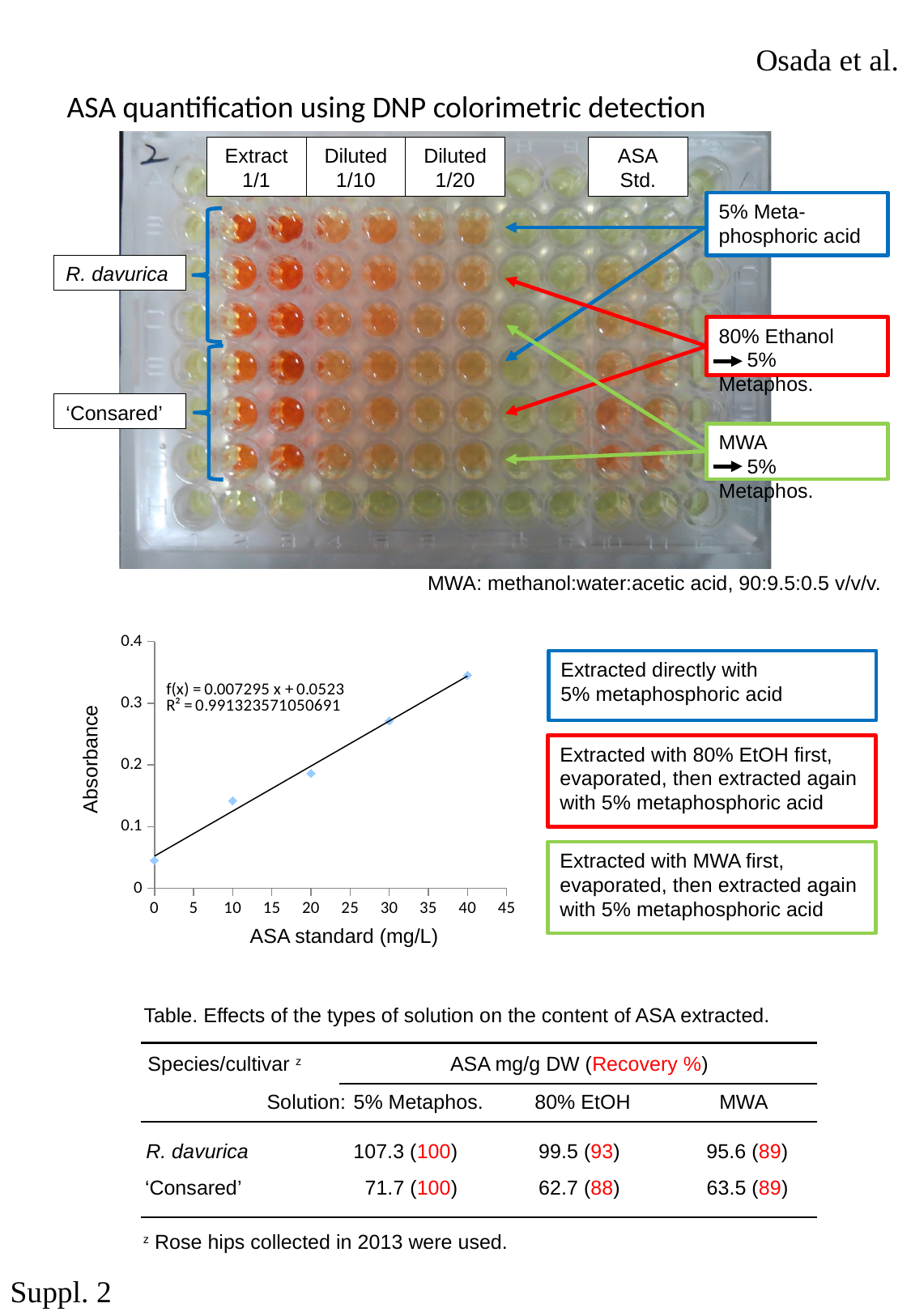
At which ASA standard concentration is the absorbance highest? 40 Is the absorbance at 40 mg/L ASA standard greater or less than 0.3? greater Does absorbance rise or fall as the ASA standard concentration increases along the x axis? rise At which ASA standard concentration is the absorbance lowest? 0 What kind of chart is shown on the slide? scatter chart What is the x-axis title of the chart? ASA standard (mg/L) Which has the larger absorbance, the point at 30 mg/L or the point at 20 mg/L? 30 mg/L How many data points are plotted in the chart? 5 Is the absorbance at 10 mg/L ASA standard greater or less than 0.1? greater What is the trendline equation printed on the chart? f(x) = 0.007295 x + 0.0523 Is the absorbance at 20 mg/L ASA standard greater or less than 0.2? less